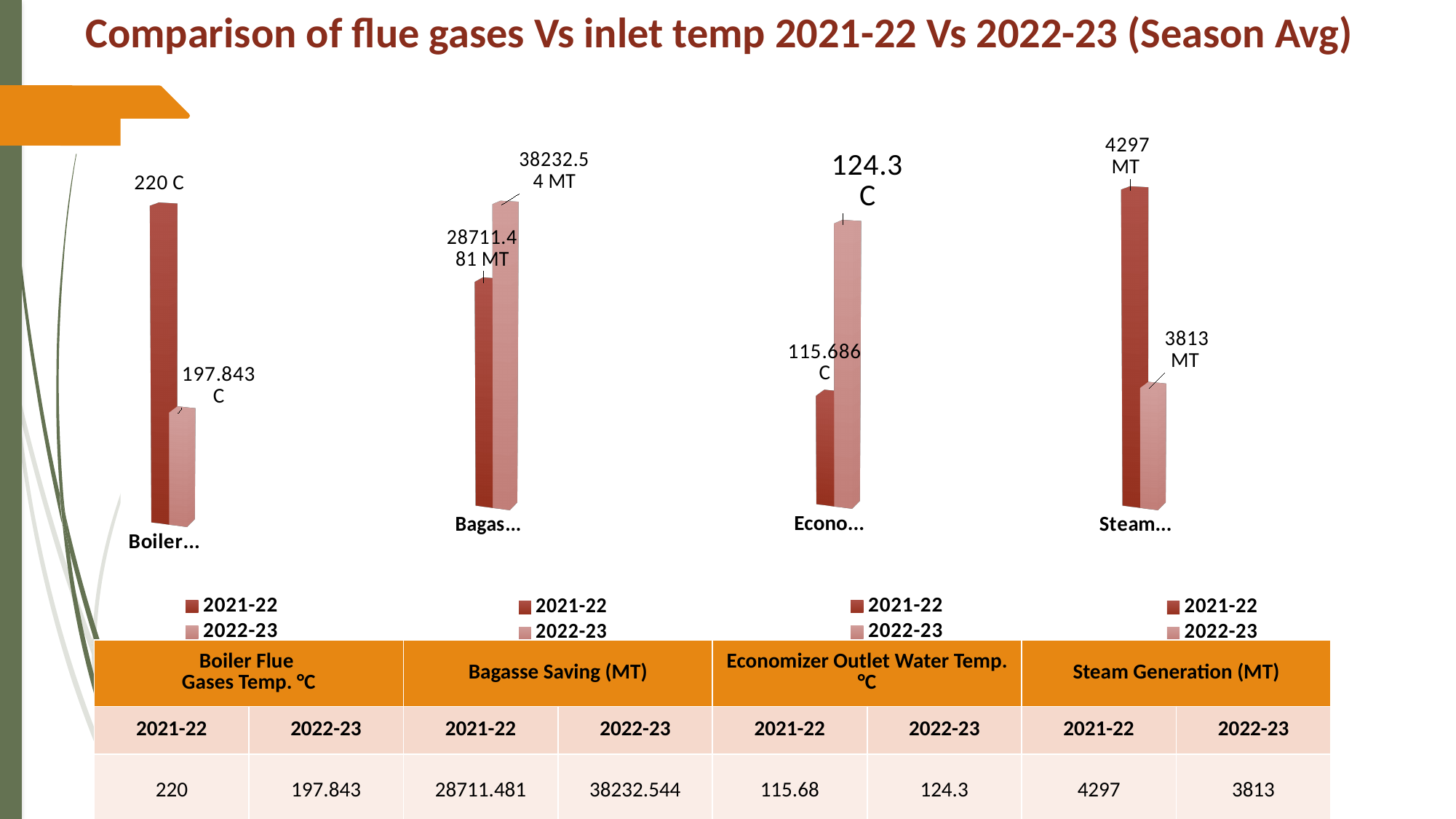
In the rightmost chart (Steam...), what is the value for 2021-22? 4297 MT In the leftmost chart (Boiler...), what is the value for 2022-23? 197.843 C What kind of chart is used for the four charts on the slide? Bar chart In the rightmost chart (Steam...), what is the difference between the 2021-22 and 2022-23 values? 484 MT In the second chart from the left (Bagas...), what is the value for 2022-23? 38232.544 MT In the leftmost chart (Boiler...), what is the difference between the 2021-22 and 2022-23 values? 22.157 C How many separate charts are shown on the slide? 4 In the leftmost chart (Boiler...), what is the value for 2021-22? 220 C How many series does the legend of each chart list? 2 In the rightmost chart (Steam...), which series has the larger value, 2021-22 or 2022-23? 2021-22 In the third chart from the left (Econo...), what is the value for 2022-23? 124.3 C In the second chart from the left (Bagas...), which series has the larger value, 2021-22 or 2022-23? 2022-23